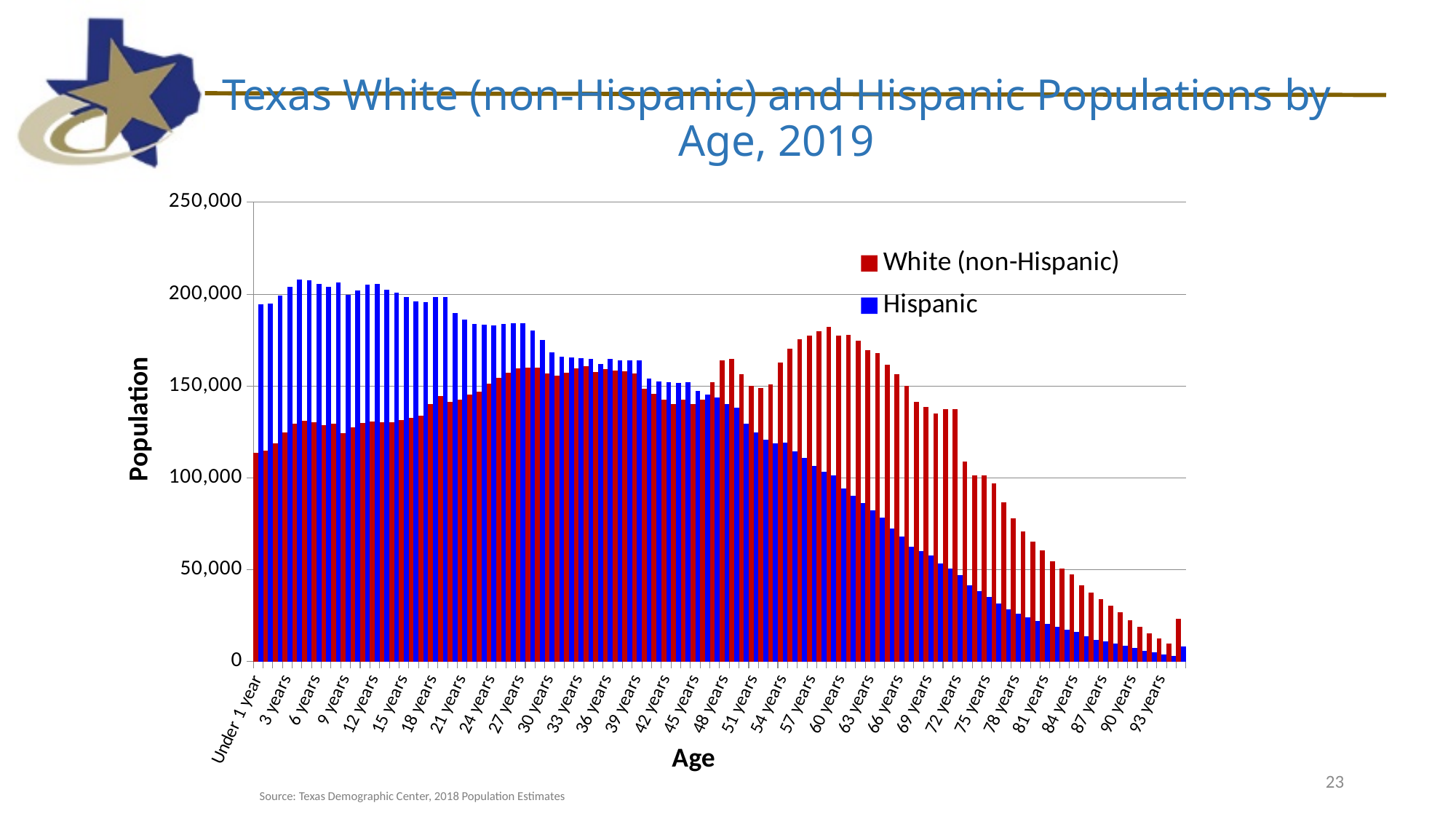
Is the Hispanic value for 60 years greater or less than 100,000? less How many series does the legend list? 2 Is the Hispanic value for 6 years greater or less than 200,000? greater Is the White (non-Hispanic) value for 93 years greater or less than 50,000? less What is the label of the vertical axis? Population At 60 years, which series has the larger value, White (non-Hispanic) or Hispanic? White (non-Hispanic) What kind of chart is shown on the slide? bar chart Which colour represents the Hispanic series in the chart? blue At 6 years, which series has the larger value, White (non-Hispanic) or Hispanic? Hispanic Do the White (non-Hispanic) values generally rise or fall from 60 years to 93 years? fall